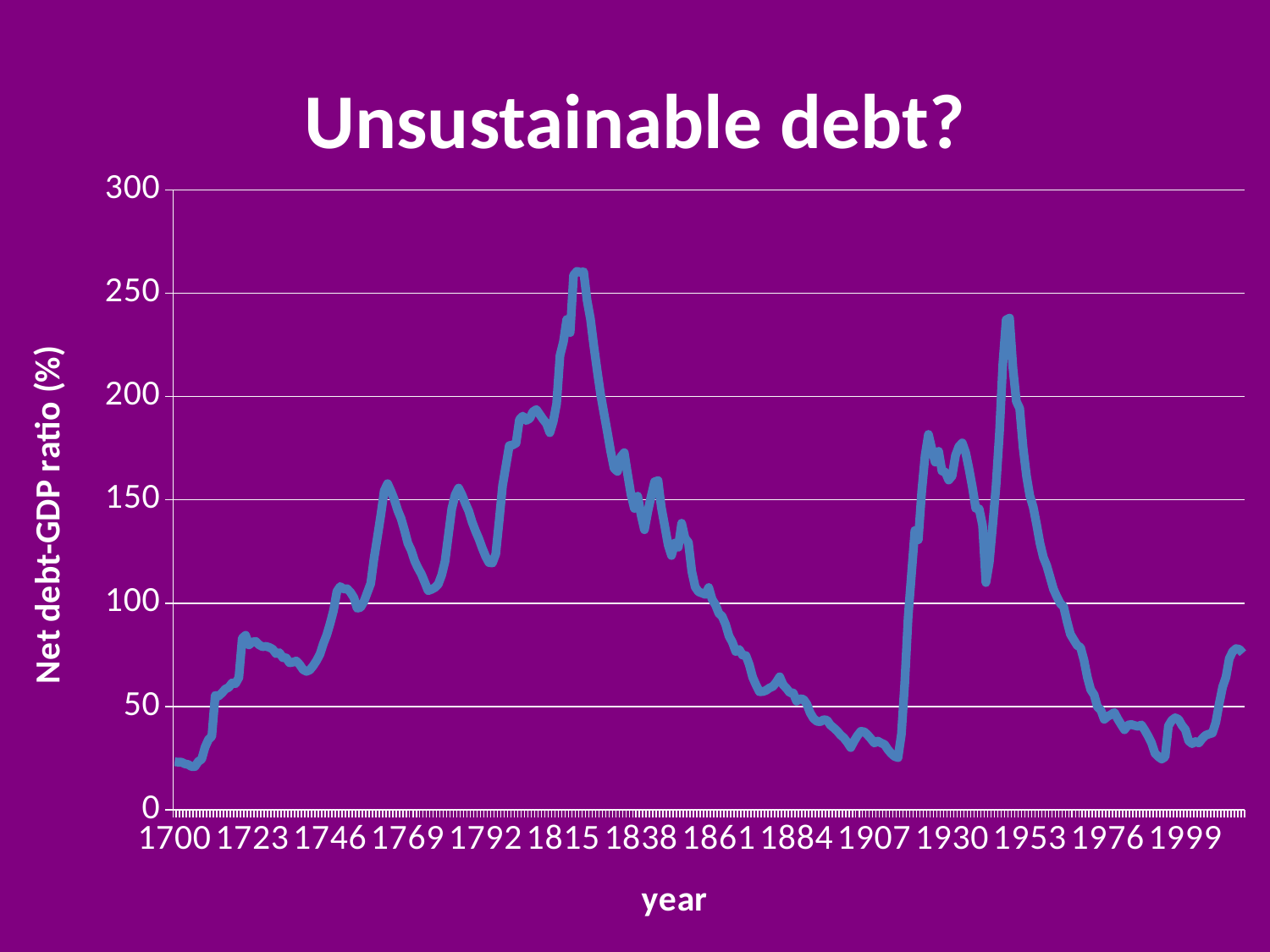
Which of the two major peaks is higher, the one around 1820 or the one around 1946? the one around 1820 What is the title of the chart? Unsustainable debt? Is the net debt-GDP ratio around 1999 greater or less than 100? less Between about 1820 and 1907, does the net debt-GDP ratio generally rise or fall? fall Which is larger, the net debt-GDP ratio around 1769 or around 1999? around 1769 What kind of chart is shown on the slide? line chart How many lines are plotted on the chart? 1 What is the label on the vertical axis of the chart? Net debt-GDP ratio (%) Is the net debt-GDP ratio around 1907 greater or less than 50? less Is the highest value reached by the line around 1820 greater or less than 200? greater